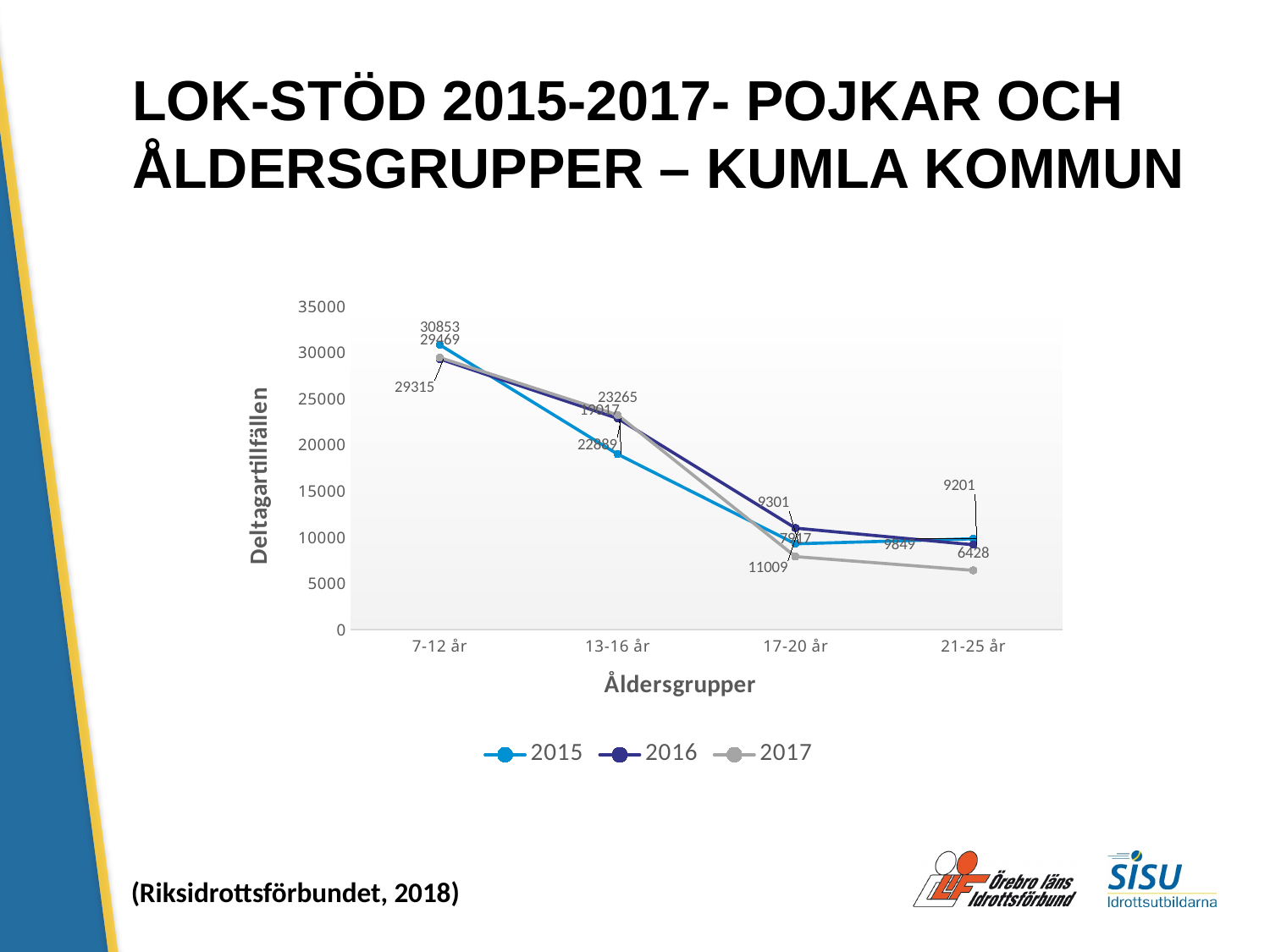
What is the value for 2017 in the 13-16 år age group? 23265 What is the title of the y axis? Deltagartillfällen In the 21-25 år age group, which is larger: the value for 2016 or the value for 2017? 2016 What type of chart is shown on the slide? line chart Which age group has the highest value for 2015? 7-12 år What is the value for 2017 in the 21-25 år age group? 6428 How many age groups are shown on the x axis? 4 What is the value for 2015 in the 7-12 år age group? 30853 Is the value for 2015 in the 13-16 år age group greater or less than 20000? less How many series does the legend list? 3 Which age group has the lowest value for 2017? 21-25 år Do the values for 2017 rise or fall across the age groups from 7-12 år to 21-25 år? fall